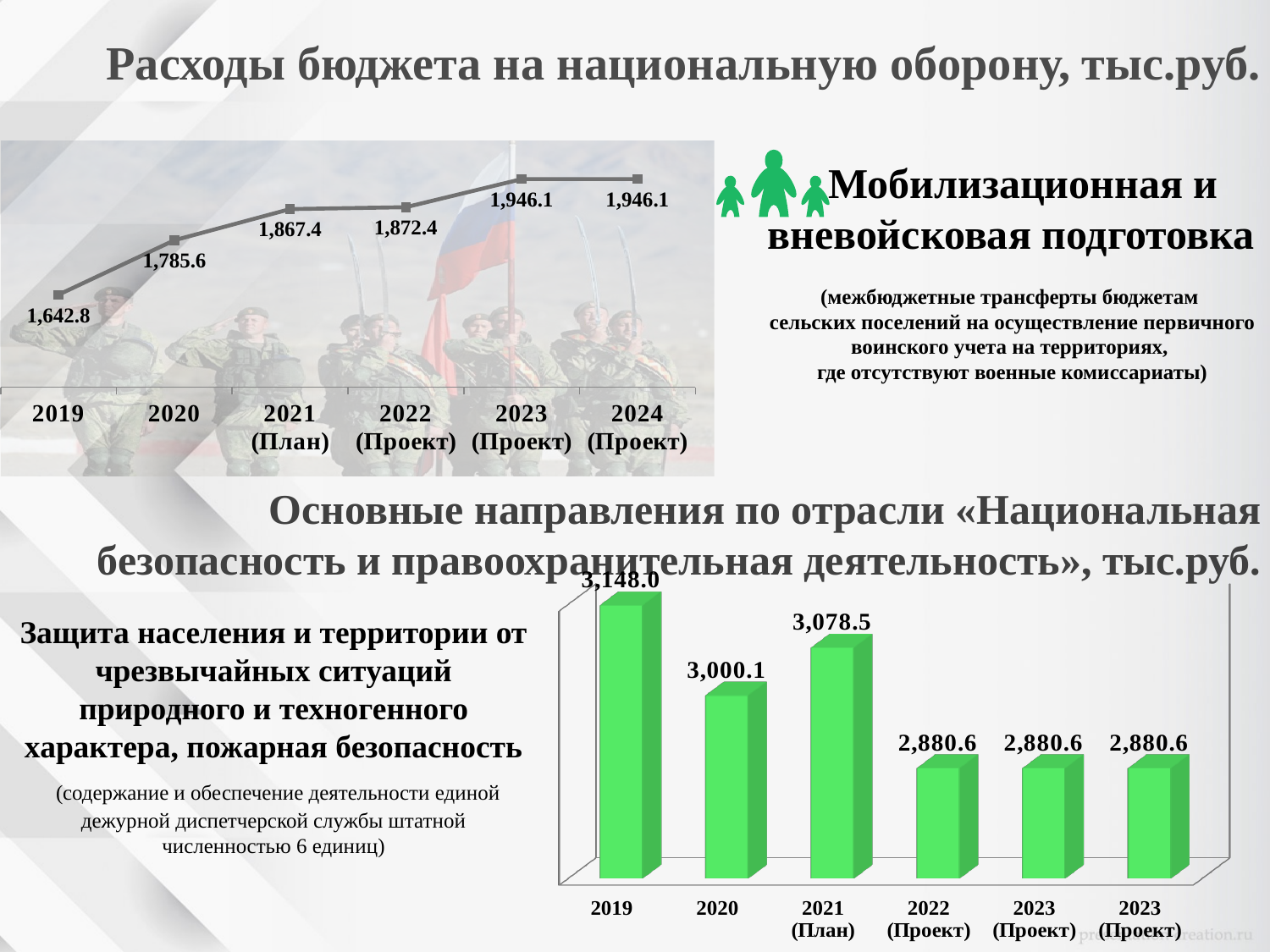
In the top line chart (Расходы бюджета на национальную оборону), which year has the lowest value? 2019 In the top line chart (Расходы бюджета на национальную оборону), what is the value for 2022 (Проект)? 1,872.4 In the bottom bar chart (Основные направления по отрасли «Национальная безопасность и правоохранительная деятельность»), which year has the highest value? 2019 In the top line chart (Расходы бюджета на национальную оборону), how many data points are plotted? 6 In the top line chart (Расходы бюджета на национальную оборону), do the values generally rise or fall from 2019 to 2024? rise In the bottom bar chart (Основные направления по отрасли «Национальная безопасность и правоохранительная деятельность»), which is larger: the value for 2020 or the value for 2021 (План)? 2021 (План) In the bottom bar chart (Основные направления по отрасли «Национальная безопасность и правоохранительная деятельность»), what is the value for 2020? 3,000.1 In the bottom bar chart (Основные направления по отрасли «Национальная безопасность и правоохранительная деятельность»), what is the difference between the 2019 value and the 2021 (План) value? 69.5 In the top line chart (Расходы бюджета на национальную оборону), what is the value for 2019? 1,642.8 In the top line chart (Расходы бюджета на национальную оборону), what is the difference between the 2020 value and the 2019 value? 142.8 What kind of chart is the bottom chart (Основные направления по отрасли «Национальная безопасность и правоохранительная деятельность»)? bar chart What kind of chart is the top chart (Расходы бюджета на национальную оборону)? line chart